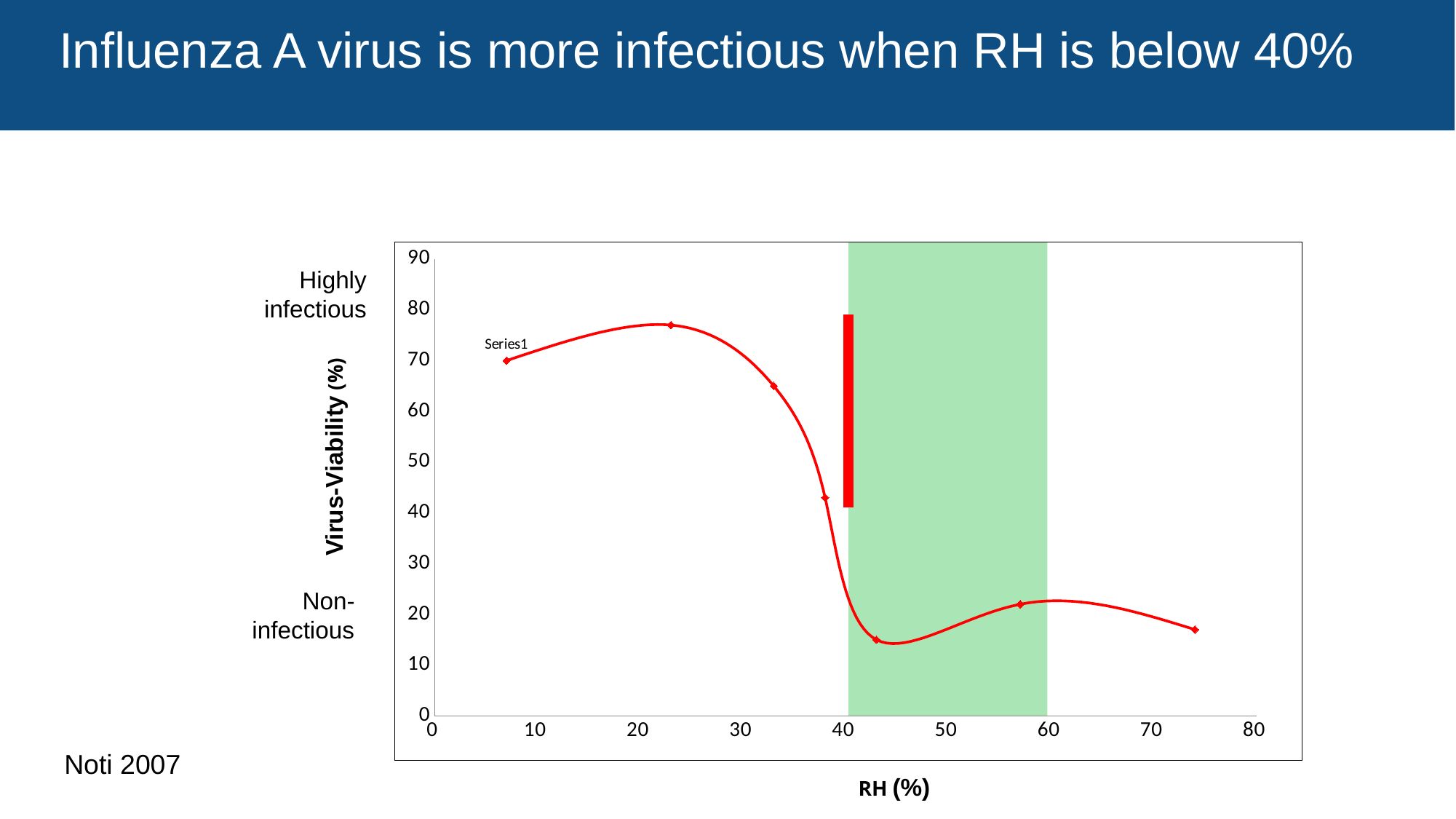
Is the virus viability of the lowest data point greater or less than 20? less Overall, does virus viability rise or fall as RH increases from 20% to 45%? fall How many data series are plotted on the chart? 1 What is the title of the y axis? Virus-Viability (%) What kind of chart is shown on the slide? line chart What is the title of the x axis? RH (%) Is the virus viability of the highest data point greater or less than 70? greater Does the highest data point lie at an RH below 40% or above 40%? below 40% Is the virus viability of the rightmost data point greater or less than 20? less How many data points are plotted on the curve? 7 Does the lowest data point lie at an RH below 40% or above 40%? above 40%